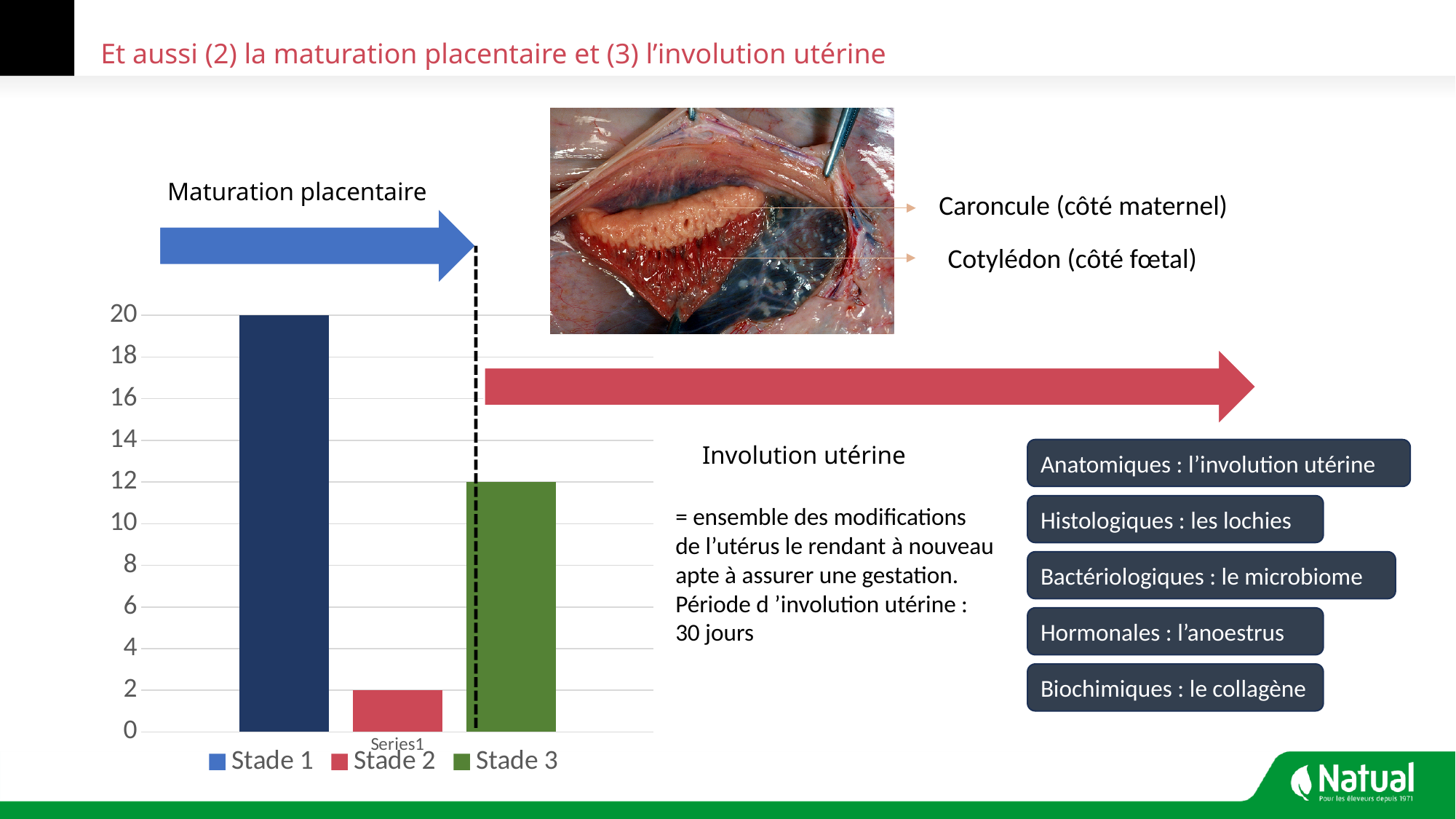
What is the value of the Stade 2 bar? 2 What is the value of the Stade 3 bar? 12 Which is larger, the Stade 3 bar or the Stade 2 bar? Stade 3 What is the value of the Stade 1 bar? 20 What kind of chart is shown on the slide? bar chart What is the difference between the Stade 3 and Stade 2 bars? 10 What is the difference between the Stade 1 and Stade 3 bars? 8 Which series has the highest bar? Stade 1 What colour is the Stade 3 bar? green How many series does the chart legend list? 3 Is the value for Stade 3 greater or less than 10? greater Which series has the lowest bar? Stade 2